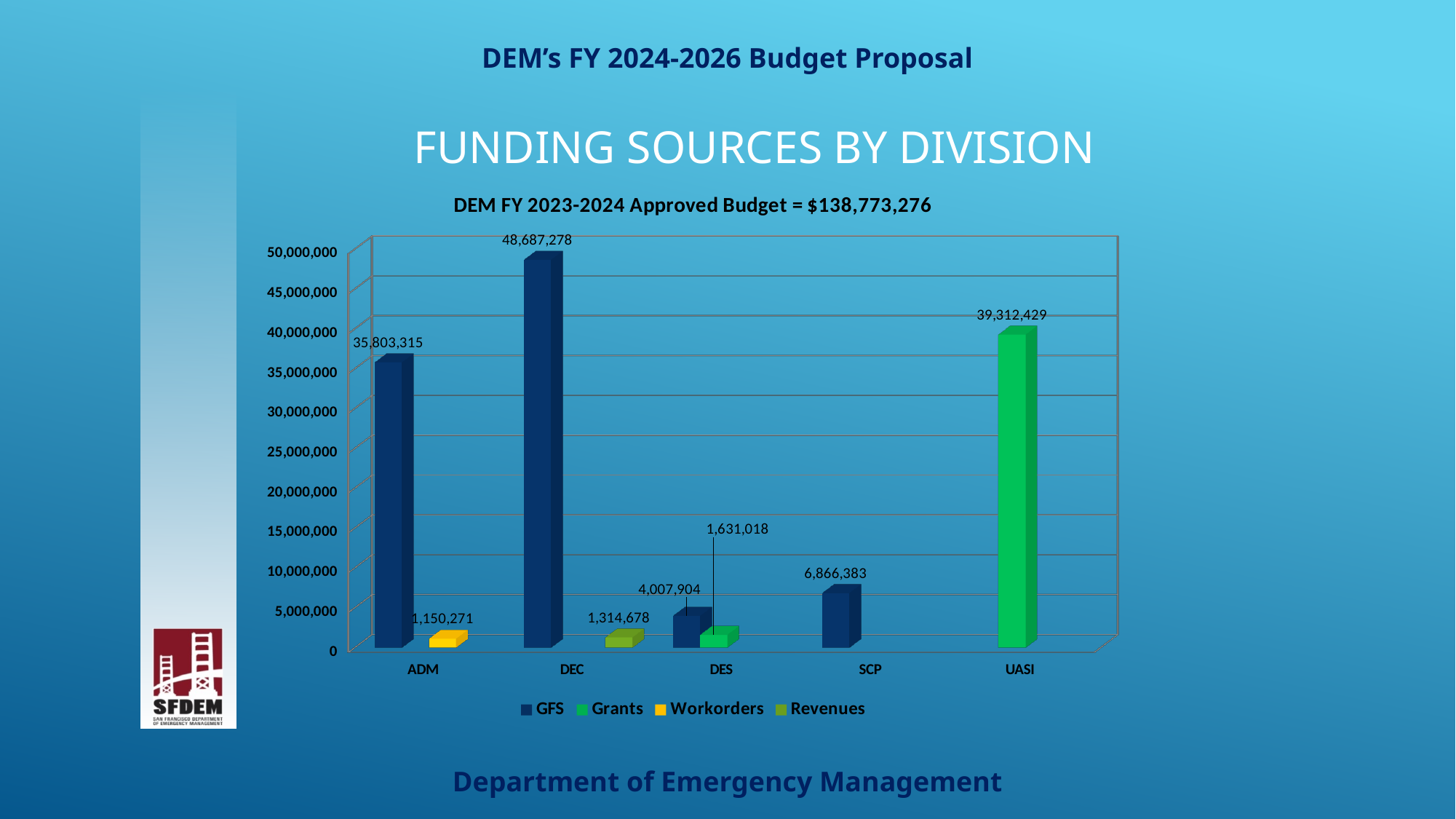
What kind of chart is shown on the slide? Bar chart Which division has the highest GFS value? DEC Which division has the lowest GFS value? DES What is the GFS value for DEC? 48,687,278 How many divisions are shown on the x axis? 5 What is the difference between the Grants values for UASI and DES? 37,681,411 What is the difference between the GFS values for DEC and ADM? 12,883,963 What is the Workorders value for ADM? 1,150,271 How many series does the legend list? 4 What is the Grants value for UASI? 39,312,429 Which is larger, the GFS value for SCP or the GFS value for DES? SCP What is the Revenues value for DEC? 1,314,678